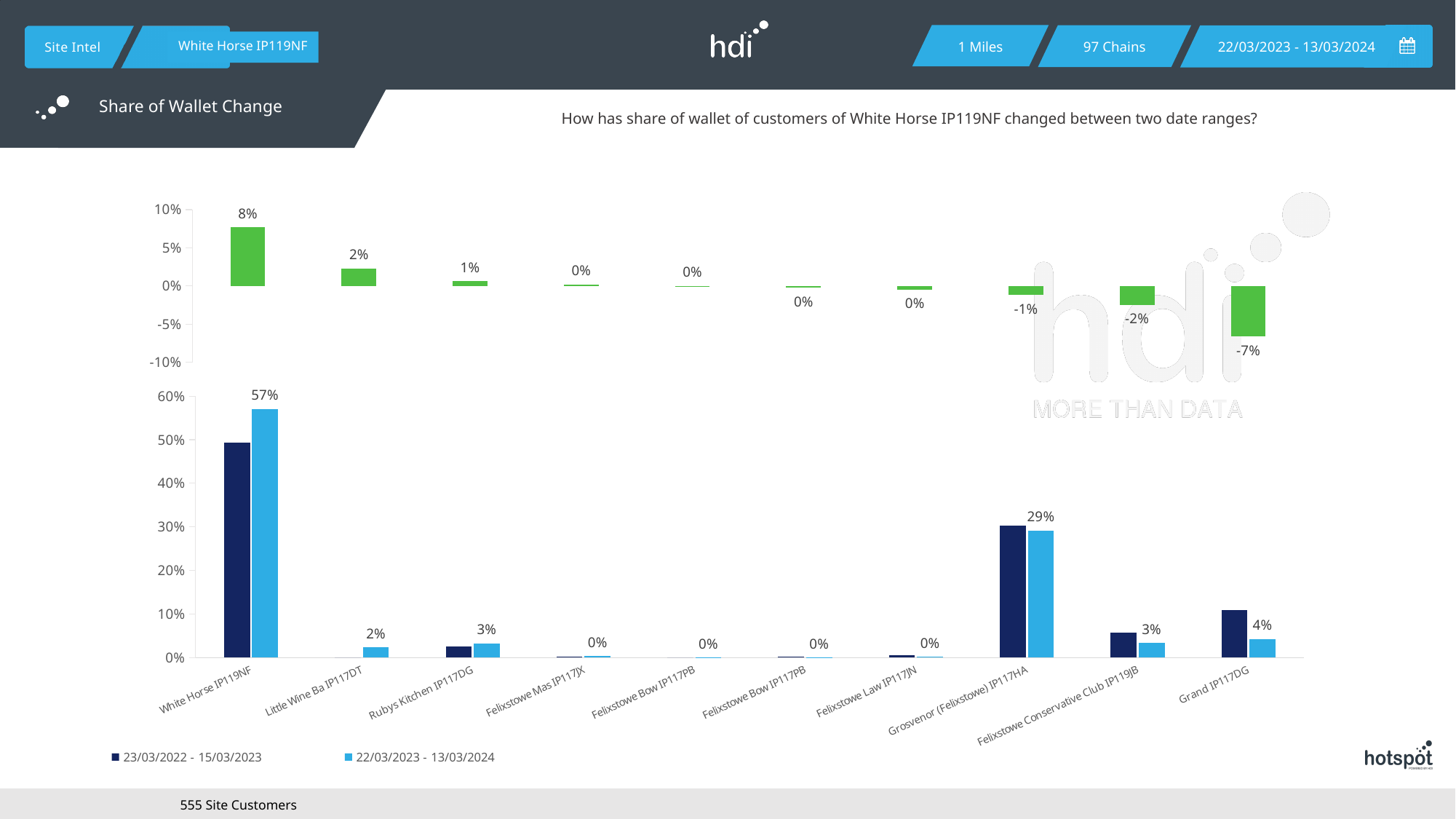
In the top chart (share of wallet change), what is the value for White Horse IP119NF? 8% In the bottom chart, for Grand IP117DG, which series has the larger value: 23/03/2022 - 15/03/2023 or 22/03/2023 - 13/03/2024? 23/03/2022 - 15/03/2023 In the top chart (share of wallet change), what is the value for Felixstowe Conservative Club IP119JB? -2% In the top chart (share of wallet change), which category has the lowest value? Grand IP117DG In the bottom chart, how many series does the legend list? 2 In the top chart (share of wallet change), which category has the highest value? White Horse IP119NF In the bottom chart, what is the difference between the 22/03/2023 - 13/03/2024 values for White Horse IP119NF and Grosvenor (Felixstowe) IP117HA? 28% In the bottom chart, how many categories are shown on the x axis? 10 In the bottom chart, is the 23/03/2022 - 15/03/2023 value for White Horse IP119NF greater or less than 40%? greater In the top chart (share of wallet change), what is the difference between the values for White Horse IP119NF and Little Wine Ba IP117DT? 6% In the bottom chart, what is the 22/03/2023 - 13/03/2024 value for Grosvenor (Felixstowe) IP117HA? 29% What kind of chart is the bottom chart? bar chart